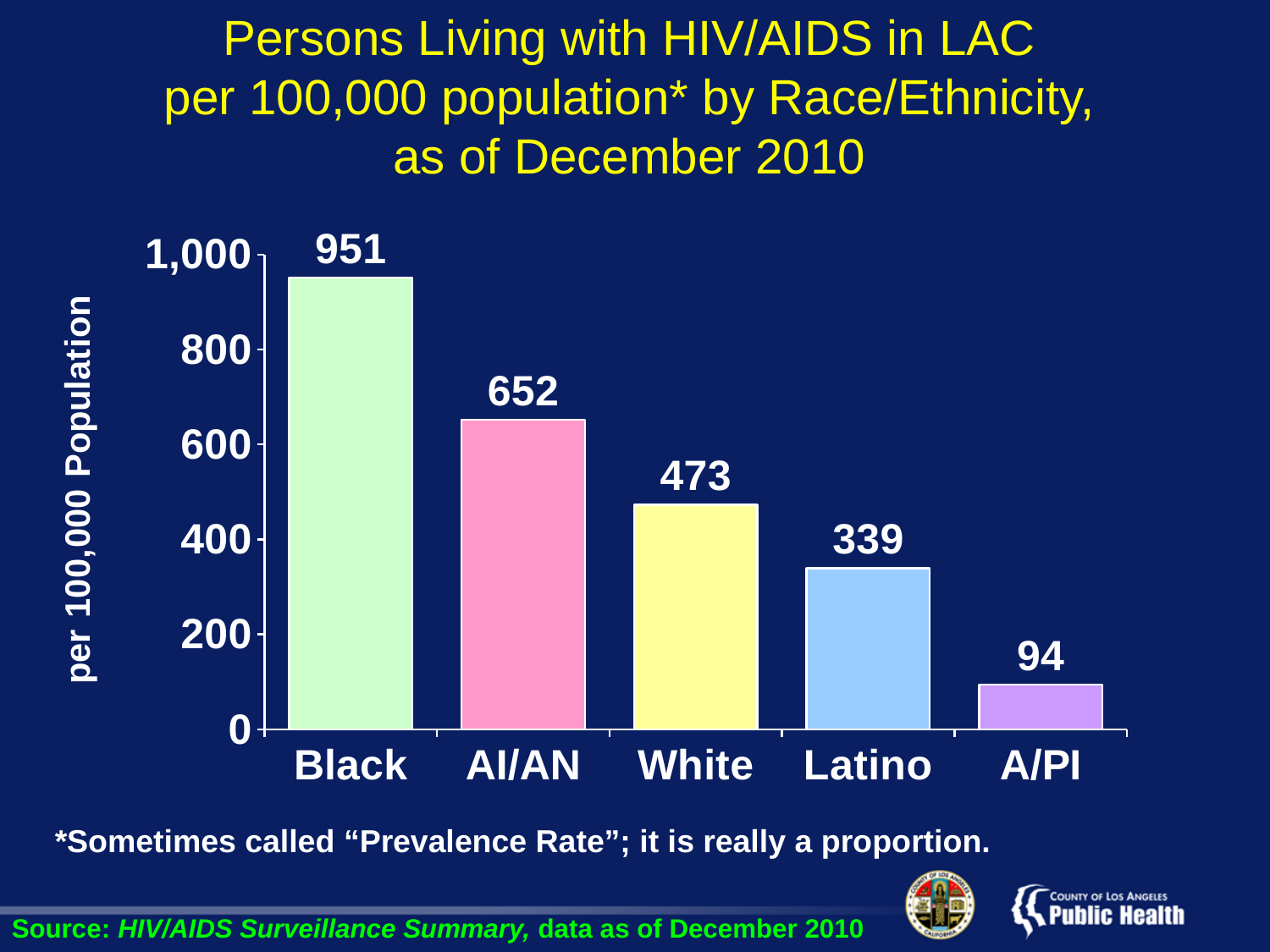
Which is larger, the value for White or the value for Latino? White What is the difference between the values for Black and AI/AN? 299 What is the value for White? 473 What kind of chart is shown on the slide? Bar chart What is the value for Black? 951 Which race/ethnicity has the highest value? Black What is the value for Latino? 339 Which race/ethnicity has the lowest value? A/PI What is the value for A/PI? 94 What is the value for AI/AN? 652 How many race/ethnicity categories are shown in the chart? 5 What is the label of the y axis? per 100,000 Population